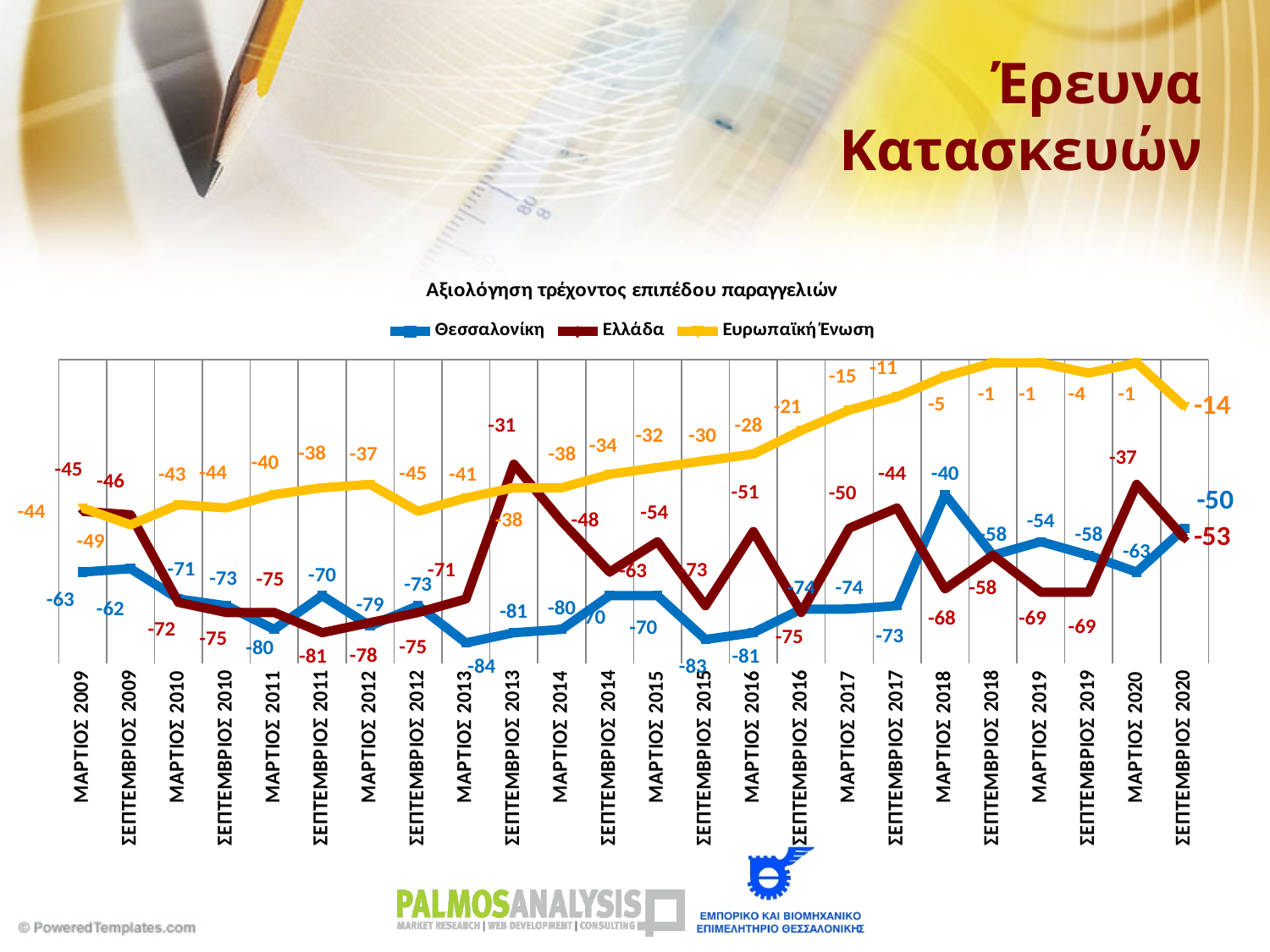
What is the value for Θεσσαλονίκη in ΜΑΡΤΙΟΣ 2018? -40 In ΣΕΠΤΕΜΒΡΙΟΣ 2020, which is higher, Θεσσαλονίκη or Ελλάδα? Θεσσαλονίκη What is the value for Ευρωπαϊκή Ένωση in ΣΕΠΤΕΜΒΡΙΟΣ 2020? -14 How many series does the legend list? 3 What is the value for Ελλάδα in ΣΕΠΤΕΜΒΡΙΟΣ 2013? -31 What is the value for Ελλάδα in ΣΕΠΤΕΜΒΡΙΟΣ 2020? -53 What type of chart is shown on the slide? line chart What is the title of the chart? Αξιολόγηση τρέχοντος επιπέδου παραγγελιών How many time points are shown on the x axis? 24 What is the difference between the Θεσσαλονίκη and Ελλάδα values in ΣΕΠΤΕΜΒΡΙΟΣ 2020? 3 What is the value for Θεσσαλονίκη in ΣΕΠΤΕΜΒΡΙΟΣ 2020? -50 Which series has the highest value in ΣΕΠΤΕΜΒΡΙΟΣ 2020? Ευρωπαϊκή Ένωση